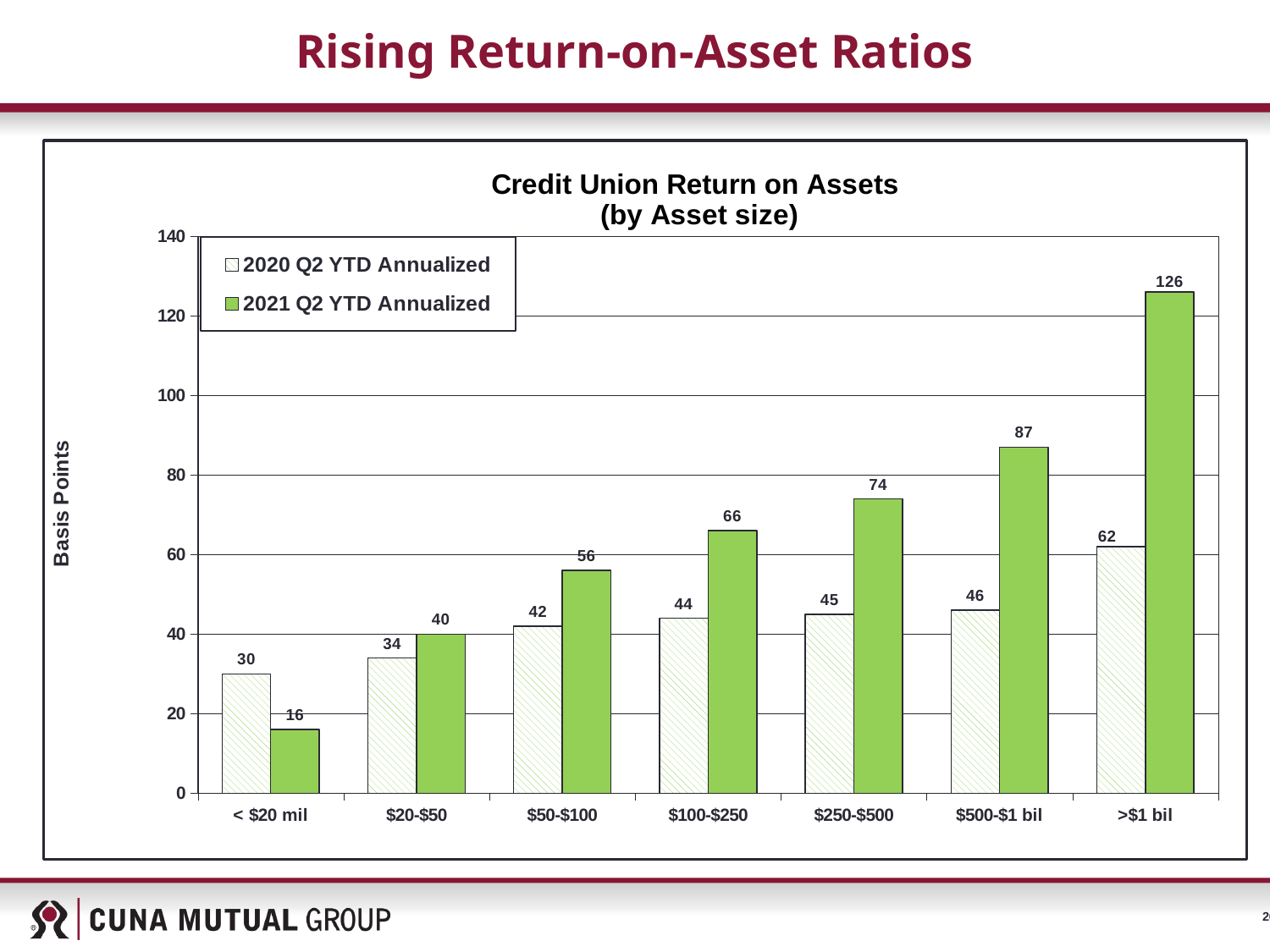
Is the 2021 Q2 YTD Annualized value for $500-$1 bil greater or less than 80? greater How many asset size categories are shown on the x axis? 7 What kind of chart is shown on the slide? Bar chart What is the 2021 Q2 YTD Annualized return on assets for credit unions with assets >$1 bil? 126 What is the 2021 Q2 YTD Annualized value for the $250-$500 asset category? 74 For the < $20 mil category, which is larger: the 2020 Q2 YTD Annualized value or the 2021 Q2 YTD Annualized value? 2020 Q2 YTD Annualized What is the 2020 Q2 YTD Annualized value for the < $20 mil asset category? 30 What is the difference between the 2021 and 2020 Q2 YTD Annualized values for the >$1 bil category? 64 How many series does the legend list? 2 Which asset size category has the highest 2021 Q2 YTD Annualized value? >$1 bil What is the label of the y axis? Basis Points Which asset size category has the lowest 2021 Q2 YTD Annualized value? < $20 mil